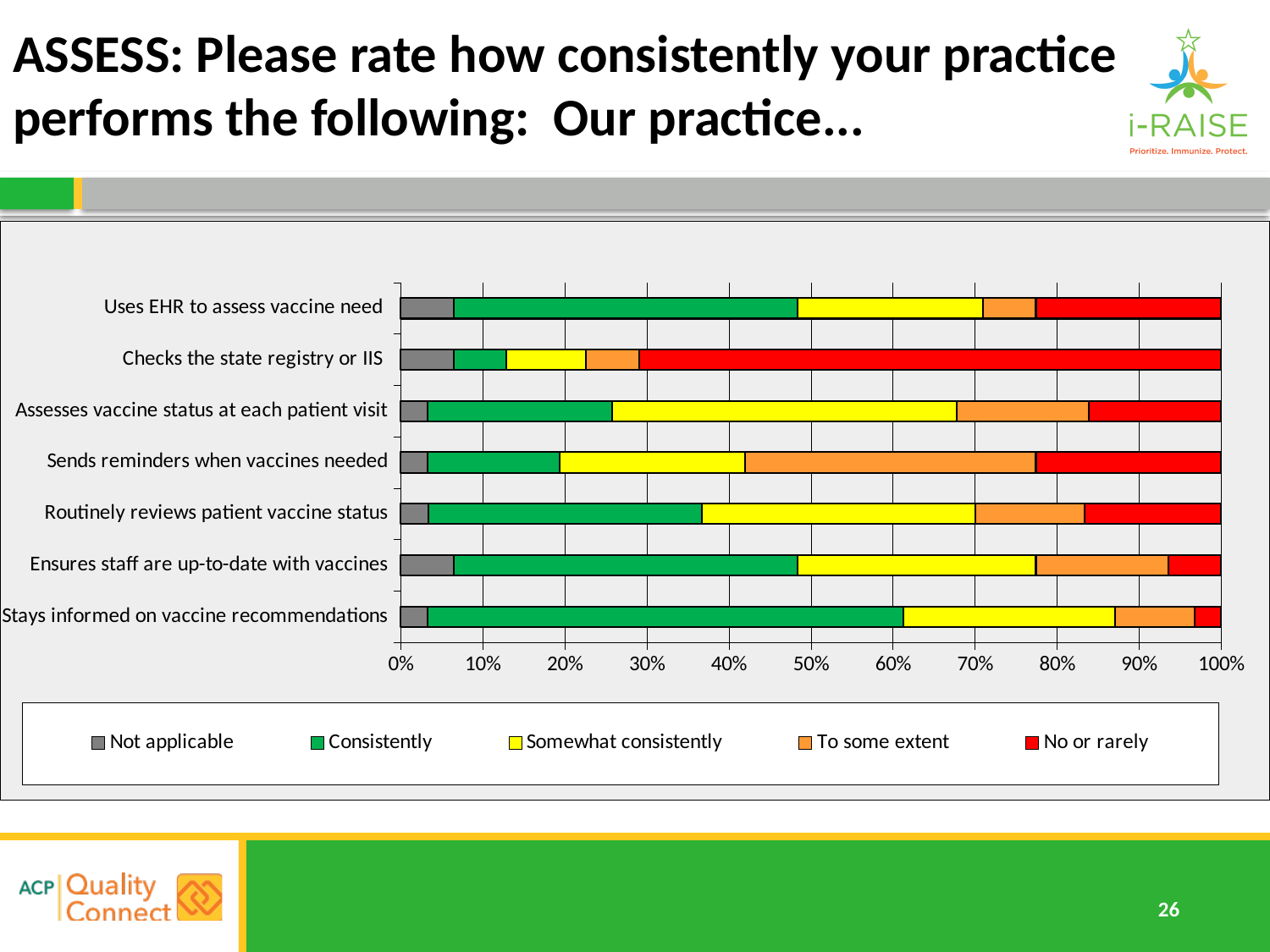
What kind of chart is shown on the slide? Stacked bar chart What colour represents the 'No or rarely' series in the legend? Red Which category has the largest 'Consistently' segment? Stays informed on vaccine recommendations Which category has the largest 'To some extent' segment? Sends reminders when vaccines needed Which category has the smallest 'Consistently' segment? Checks the state registry or IIS Which category has the largest 'No or rarely' segment? Checks the state registry or IIS How many series does the legend list? 5 Which has a larger 'Consistently' segment: 'Uses EHR to assess vaccine need' or 'Sends reminders when vaccines needed'? Uses EHR to assess vaccine need Is the 'Consistently' share for 'Stays informed on vaccine recommendations' greater or less than 50%? greater Is the 'No or rarely' share for 'Checks the state registry or IIS' greater or less than 50%? greater How many practice activities (categories) are listed on the chart? 7 What do the segments of each bar add up to, as shown by the end of the bars on the axis? 100%